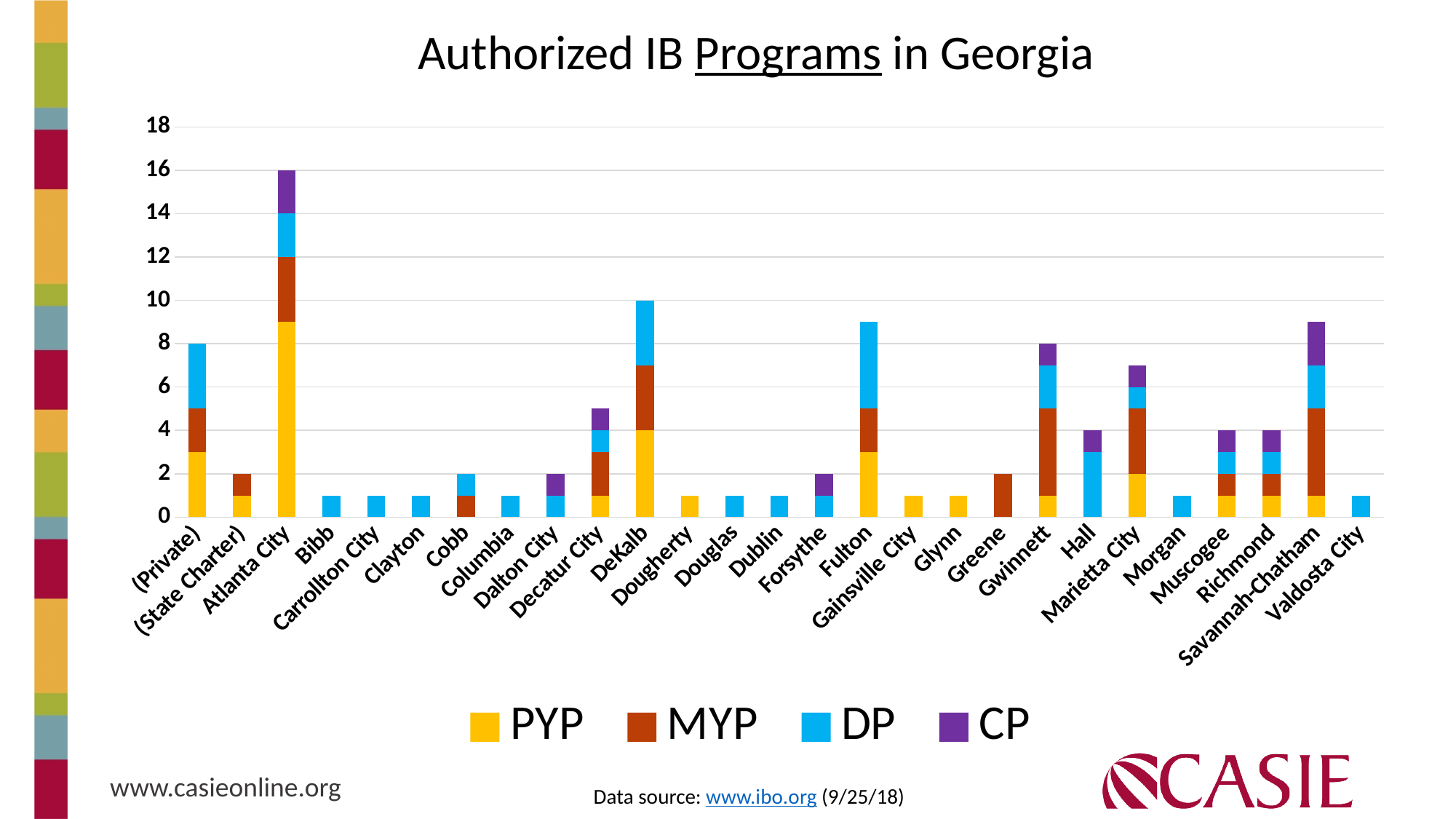
Which category has the highest total number of authorized IB programs? Atlanta City Which has a larger total, Gwinnett or Hall? Gwinnett What is the title of the chart? Authorized IB Programs in Georgia What is the total height of the stacked bar for DeKalb? 10 How many categories are shown along the x axis? 27 Is the total value for Marietta City greater or less than 8? less Which series is shown in purple in the legend? CP What kind of chart is shown on the slide? Stacked bar chart How many series does the legend list? 4 Is the total value for Fulton greater or less than 8? greater What is the difference between the total for Atlanta City and the total for DeKalb? 6 What is the total height of the stacked bar for Atlanta City? 16